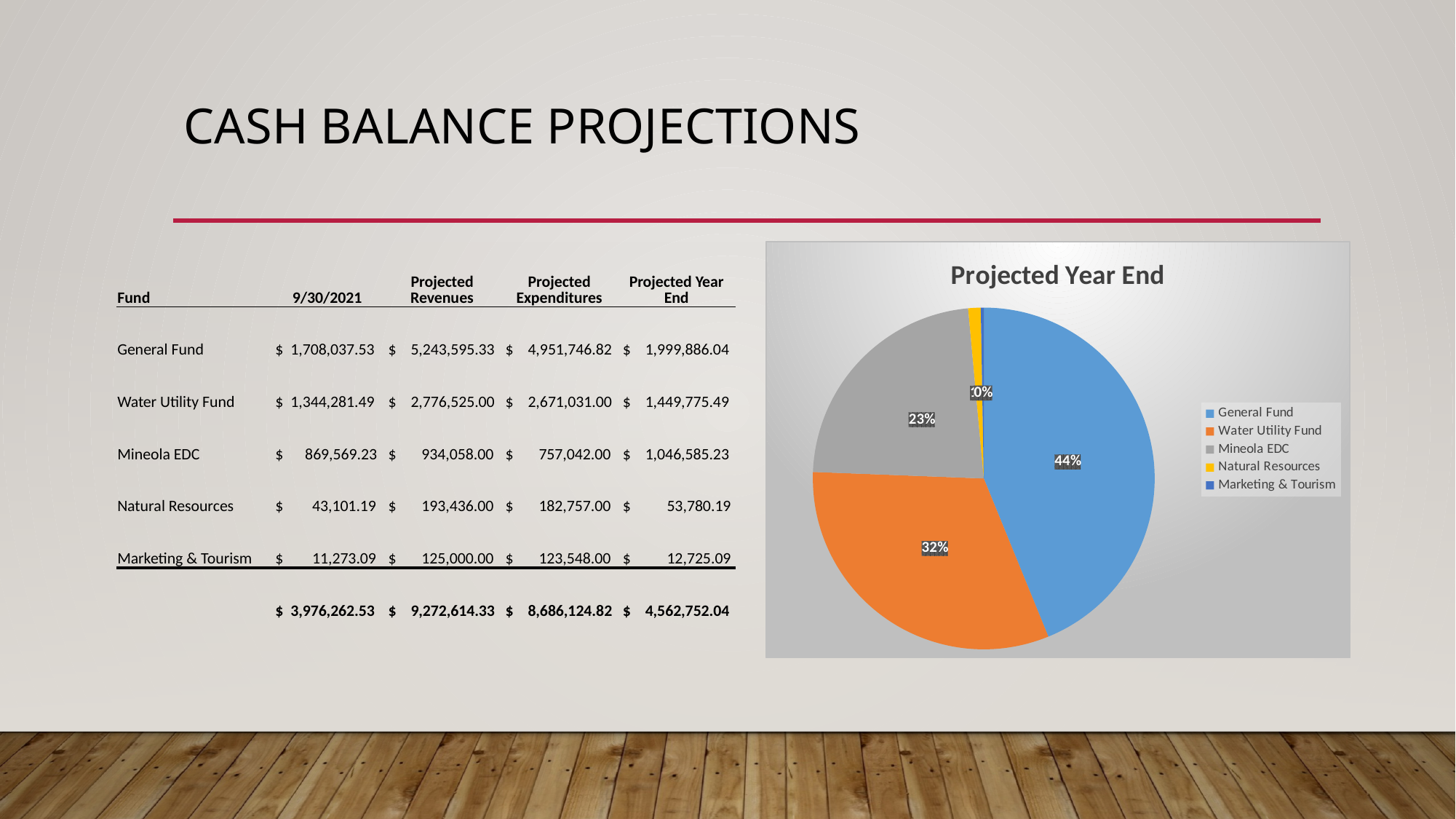
What share of the pie does Mineola EDC represent? 23% Which fund has the largest slice of the pie? General Fund What is the difference in percentage points between the General Fund slice and the Water Utility Fund slice? 12% What colour is the Water Utility Fund slice? orange What kind of chart is shown on the slide? pie chart How many funds are listed in the chart's legend? 5 Which slice is larger, General Fund or Water Utility Fund? General Fund What is the difference in percentage points between the Water Utility Fund slice and the Mineola EDC slice? 9% What share of the pie does General Fund represent? 44% What is the title of the chart? Projected Year End Which slice is larger, Mineola EDC or Water Utility Fund? Water Utility Fund What share of the pie does Water Utility Fund represent? 32%